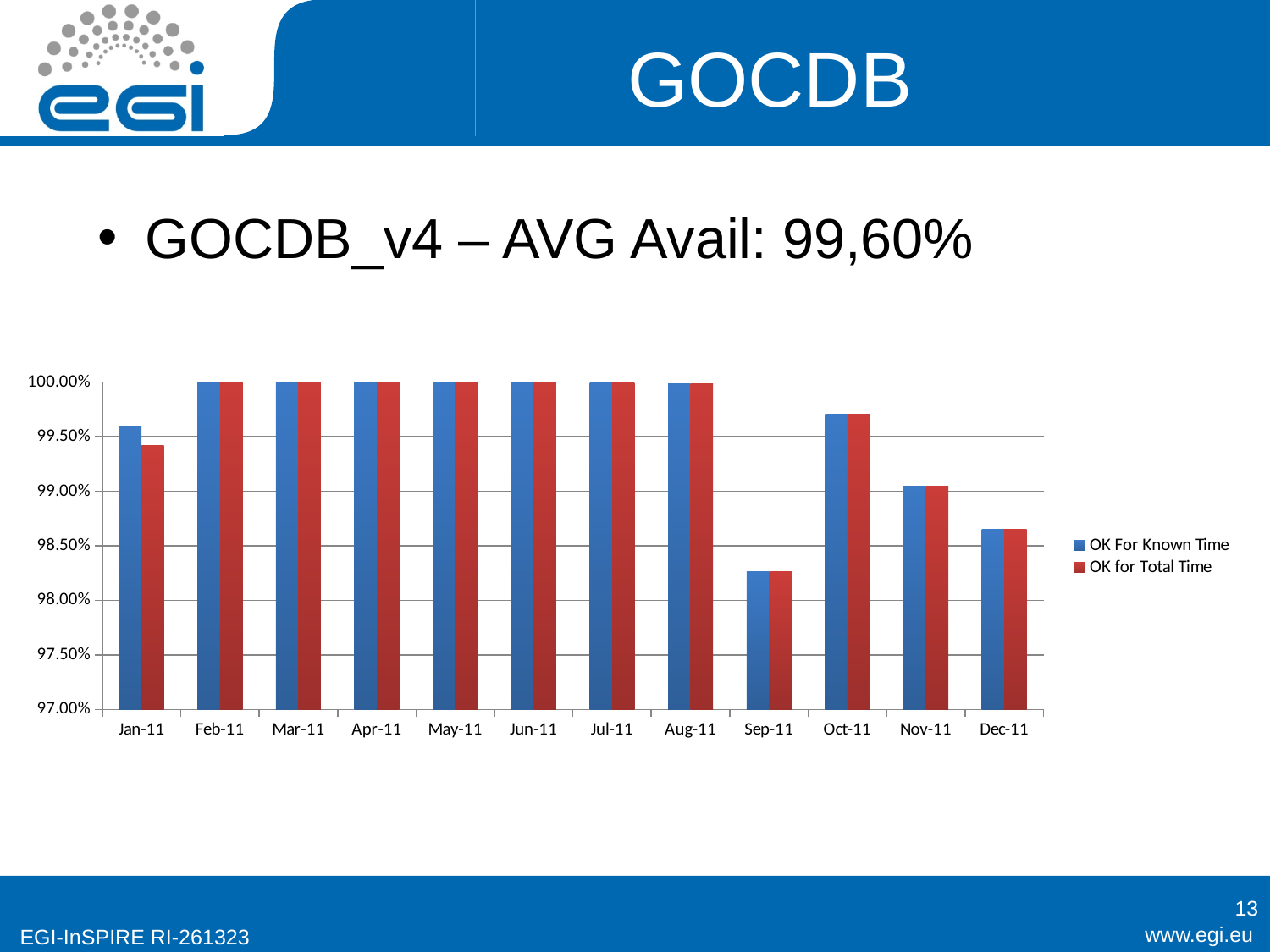
What kind of chart is shown on the slide? bar chart How many series does the legend list? 2 Is the OK For Known Time value for Jan-11 greater or less than 99.50%? greater Which month has the lowest availability values? Sep-11 Is the OK for Total Time value for Dec-11 greater or less than 98.50%? greater For Jan-11, which is larger: OK For Known Time or OK for Total Time? OK For Known Time Is the OK for Total Time value for Jan-11 greater or less than 99.50%? less Which month has the higher OK For Known Time value, Oct-11 or Nov-11? Oct-11 What are the two series named in the legend? OK For Known Time and OK for Total Time How many months are shown on the x axis? 12